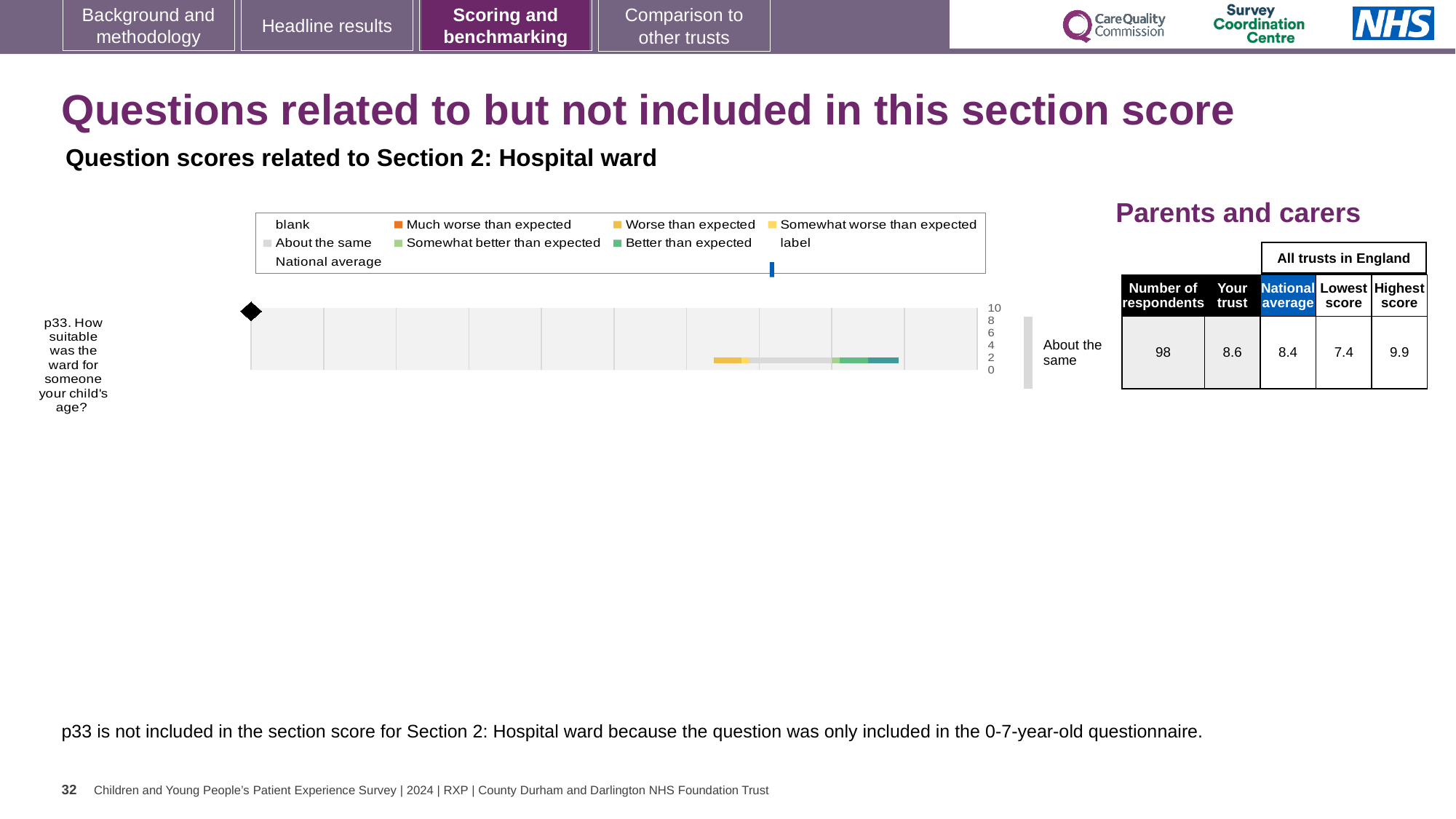
Which is larger for p33: the trust's score or the national average? the trust's score Which question is plotted in the chart? p33. How suitable was the ward for someone your child's age? What is the 'Your trust' score for p33 shown in the table beside the chart? 8.6 How many questions (categories) are plotted in the chart? 1 What is the highest value shown on the chart's score axis? 10 What is the difference between the trust's score and the national average for p33? 0.2 What kind of chart is shown on the slide? bar chart What is the difference between the highest score (9.9) and the lowest score (7.4) for p33 in the table? 2.5 How many respondents answered p33 according to the table beside the chart? 98 What benchmark label is shown next to the bar for p33? About the same Is the trust's score for p33 greater or less than 8 on the chart's axis? greater What is the national average score for p33 shown in the table beside the chart? 8.4